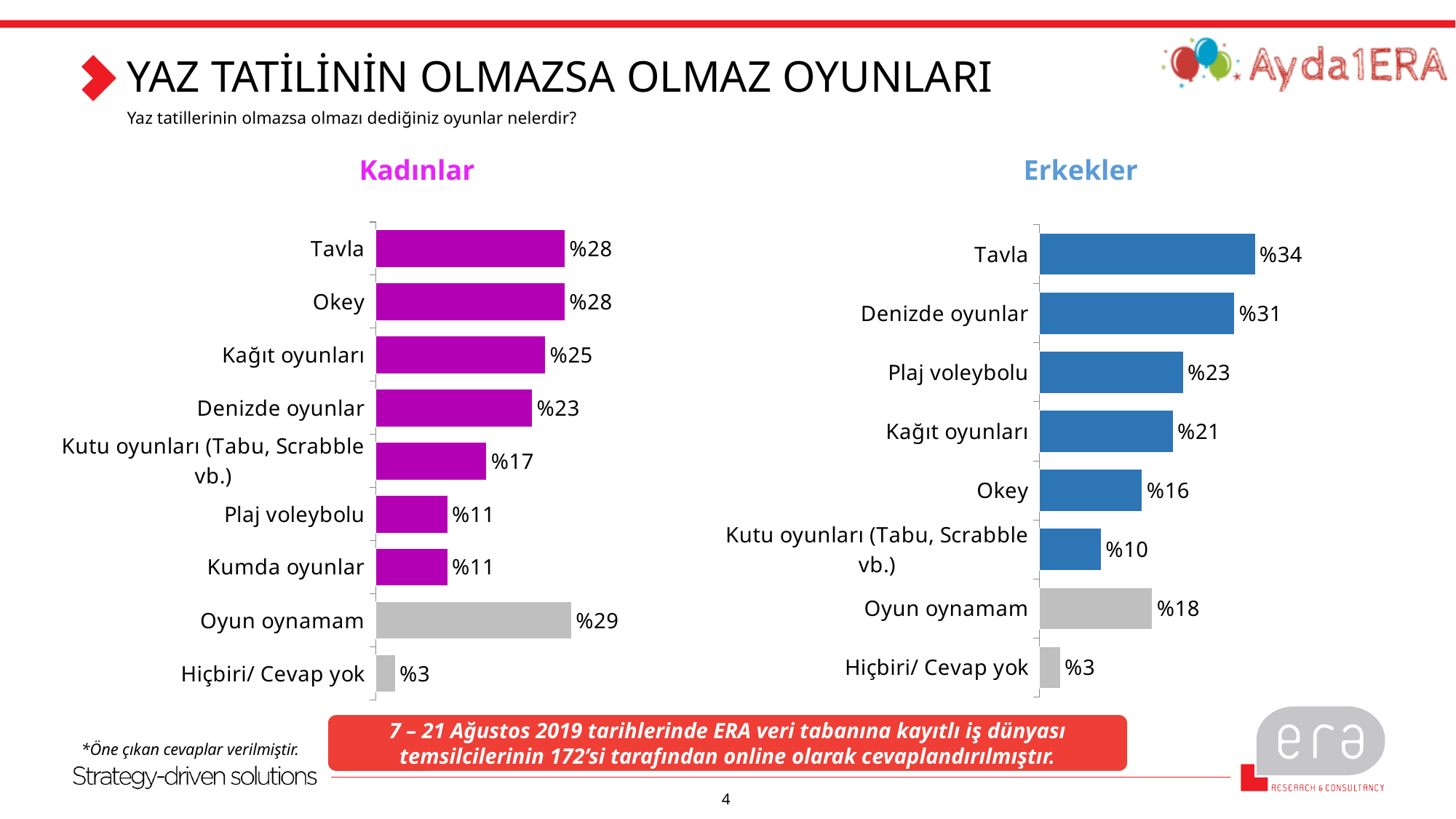
In the Kadınlar chart, what is the value for Kağıt oyunları? %25 In the Erkekler chart, what is the value for Denizde oyunlar? %31 What type of chart is used for the Erkekler data? Bar chart In the Erkekler chart, which category has the highest value? Tavla How many categories does the Erkekler chart show? 8 In the Kadınlar chart, which category has the lowest value? Hiçbiri/ Cevap yok How many categories does the Kadınlar chart show? 9 Which is larger: Okey in the Kadınlar chart or Okey in the Erkekler chart? Kadınlar In the Kadınlar chart, which category has the highest value? Oyun oynamam What is the difference between the Tavla values in the Erkekler chart and the Kadınlar chart? 6 percentage points In the Erkekler chart, what is the difference between Plaj voleybolu and Kutu oyunları (Tabu, Scrabble vb.)? 13 percentage points In the Erkekler chart, what is the value for Okey? %16